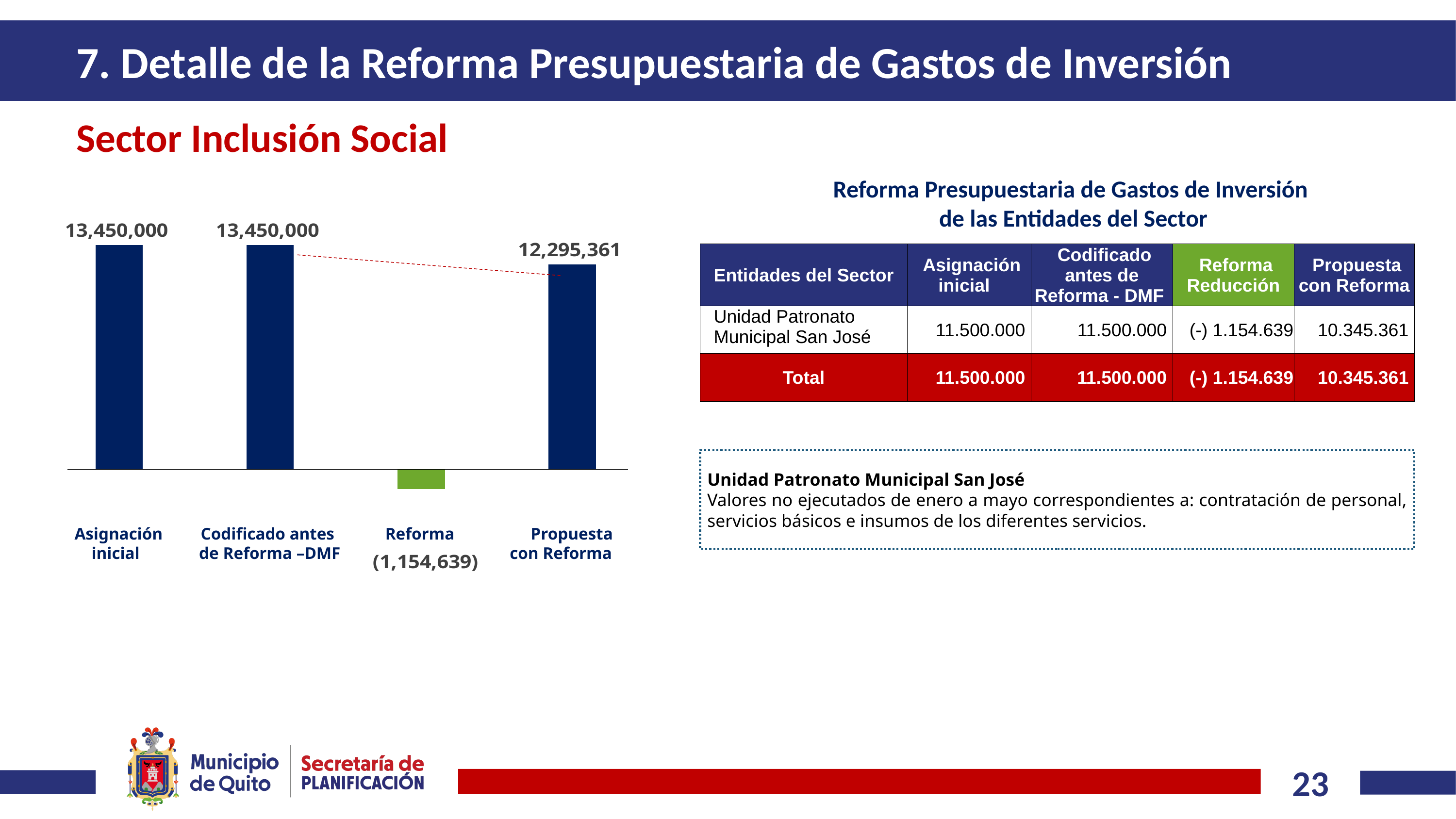
What is the value of the Codificado antes de Reforma –DMF bar in the chart? 13,450,000 Do the values in the chart rise or fall from Codificado antes de Reforma –DMF to Propuesta con Reforma? Fall What is the value of the Asignación inicial bar in the chart? 13,450,000 How many bars are plotted in the chart? 4 Which category in the chart has the lowest value? Reforma What is the value of the Propuesta con Reforma bar in the chart? 12,295,361 What is the value shown for the Reforma bar in the chart? (1,154,639) What is the difference between the Codificado antes de Reforma –DMF bar and the Propuesta con Reforma bar? 1,154,639 What kind of chart is shown on the slide? Bar chart Is the Reforma bar in the chart above or below the horizontal axis? Below Which is larger in the chart, Asignación inicial or Propuesta con Reforma? Asignación inicial Which bar in the chart is coloured green? Reforma